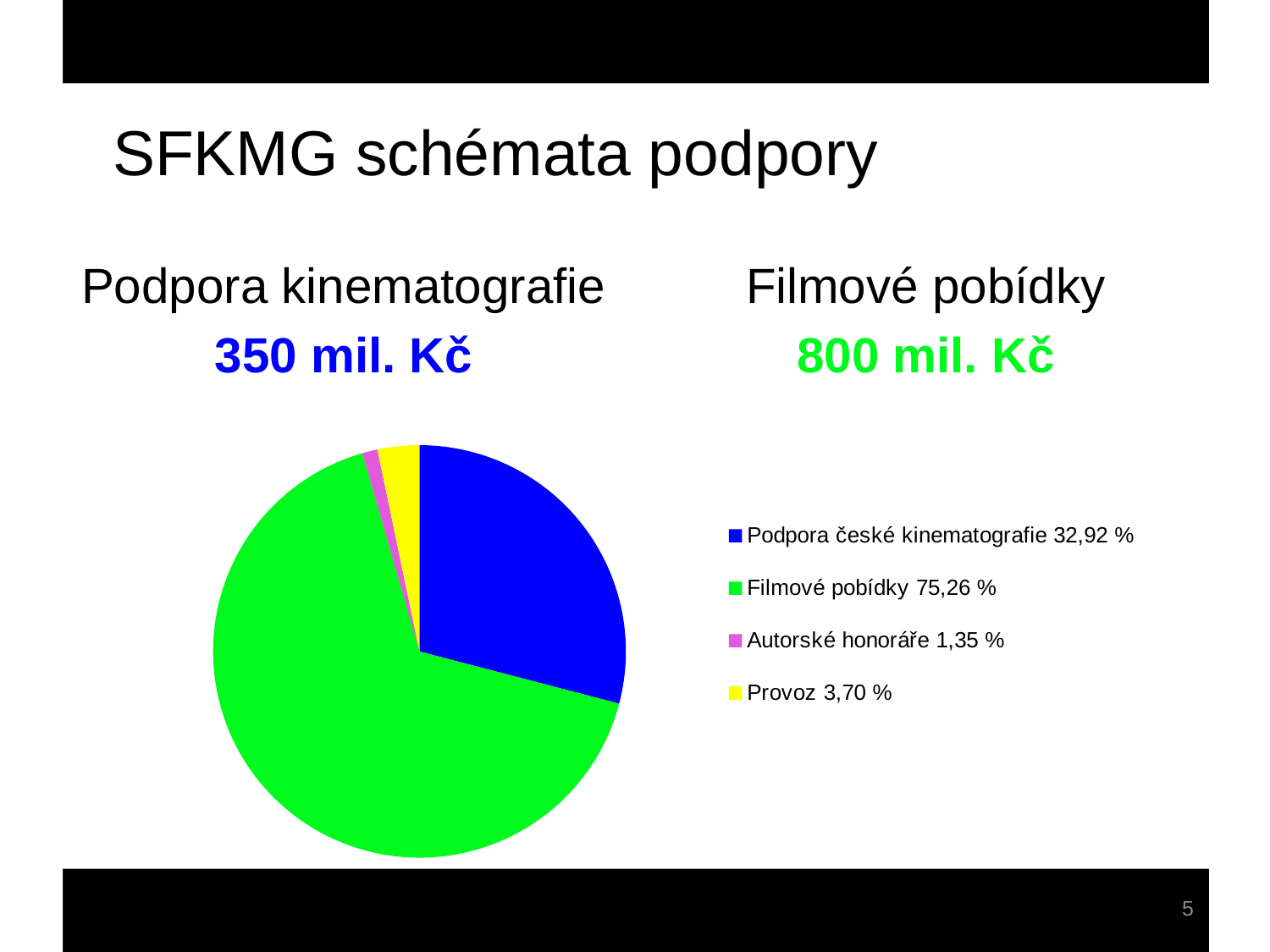
What colour is the slice for Filmové pobídky in the pie chart? green Which slice of the pie chart is the smallest? Autorské honoráře How many slices does the pie chart have? 4 What colour is the slice for Podpora české kinematografie in the pie chart? blue What percentage does the legend give for Filmové pobídky? 75,26 % Which slice of the pie chart is the largest? Filmové pobídky What percentage does the legend give for Provoz? 3,70 % What percentage does the legend give for Podpora české kinematografie? 32,92 % Which is larger, the slice for Provoz or the slice for Autorské honoráře? Provoz How many entries does the legend of the pie chart list? 4 What kind of chart is shown on the slide? pie chart What percentage does the legend give for Autorské honoráře? 1,35 %